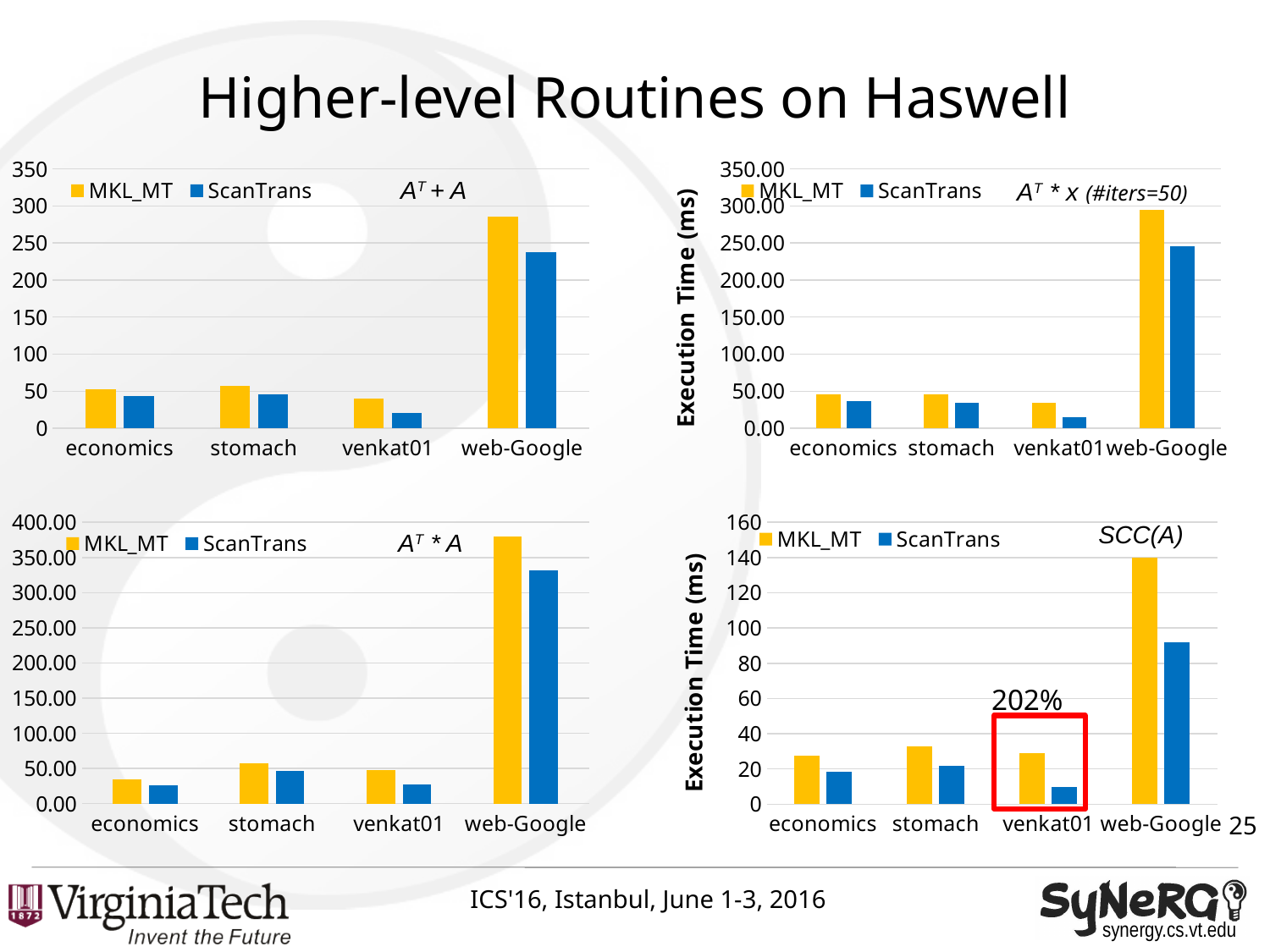
In the bottom-left chart (A^T * A), which is larger for web-Google, MKL_MT or ScanTrans? MKL_MT In the top-left chart (A^T + A), is the MKL_MT value for web-Google greater or less than 250? greater In the top-left chart (A^T + A), which category has the lowest ScanTrans value? venkat01 In the top-right chart (A^T * x), how many series does the legend list? 2 In the bottom-right chart (SCC(A)), is the MKL_MT value for web-Google greater or less than 120? greater In the bottom-right chart (SCC(A)), what percentage is annotated above the venkat01 bars? 202% In the top-right chart (A^T * x), is the MKL_MT value for venkat01 greater or less than 50.00? less What kind of chart is the top-left chart (A^T + A)? bar chart In the bottom-right chart (SCC(A)), which category has the lowest ScanTrans value? venkat01 In the bottom-left chart (A^T * A), how many categories are shown on the x axis? 4 In the top-left chart (A^T + A), which category has the highest MKL_MT value? web-Google